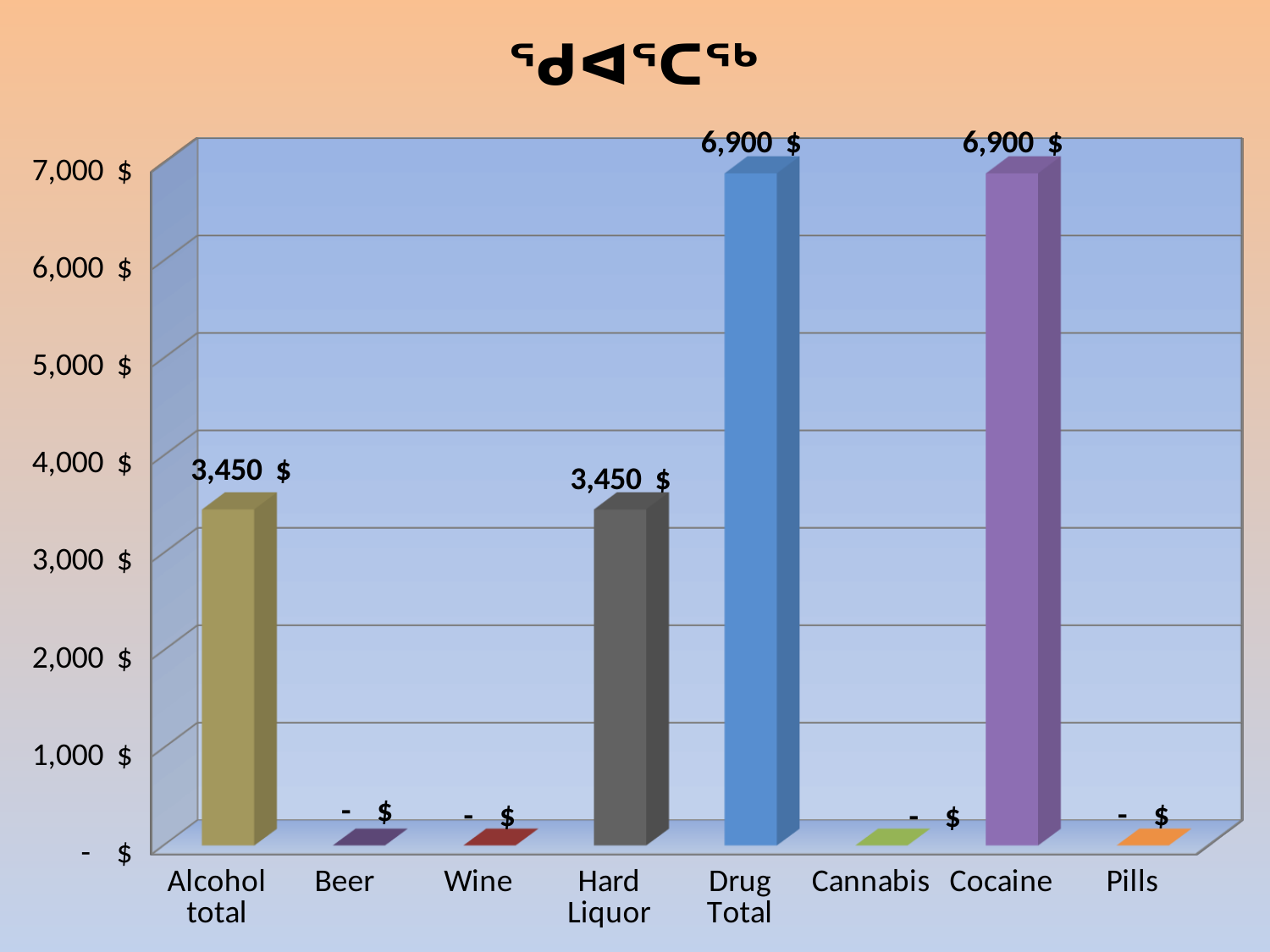
What is the value for Hard Liquor? 3,450 $ What is the highest value shown in the chart? 6,900 $ Is the value for Alcohol total greater or less than 3,000? greater What is the value shown for Beer? - $ What is the value for Drug Total? 6,900 $ What is the value for Cocaine? 6,900 $ What is the value for Alcohol total? 3,450 $ What is the difference between the values for Drug Total and Alcohol total? 3,450 $ How many categories are shown on the x axis? 8 Which is larger, the value for Cocaine or the value for Hard Liquor? Cocaine Are the values for Alcohol total and Hard Liquor equal? Yes What kind of chart is shown on the slide? bar chart